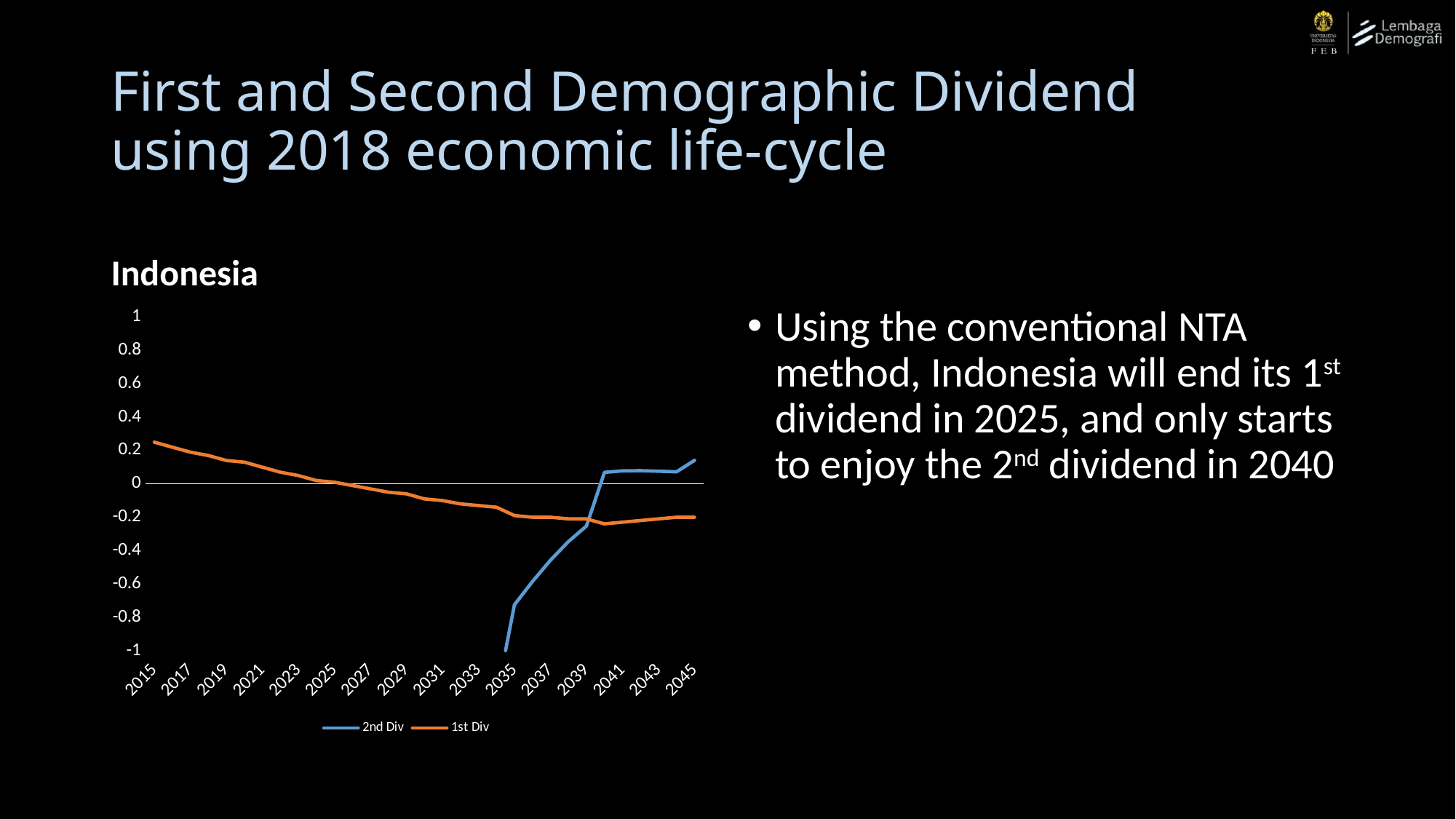
Does the 1st Div line rise or fall overall from 2015 to 2045? Fall Is the value for 1st Div in 2015 greater or less than 0? greater What kind of chart is shown on the slide? Line chart Is the value for 2nd Div in 2045 greater or less than 0? greater In 2045, which series has the higher value, 2nd Div or 1st Div? 2nd Div How many series does the chart legend list? 2 Is the value for 1st Div in 2045 greater or less than 0? less Does the 2nd Div line rise or fall from 2035 to 2045? Rise What are the two series named in the chart legend? 2nd Div and 1st Div What is the title of the chart? Indonesia